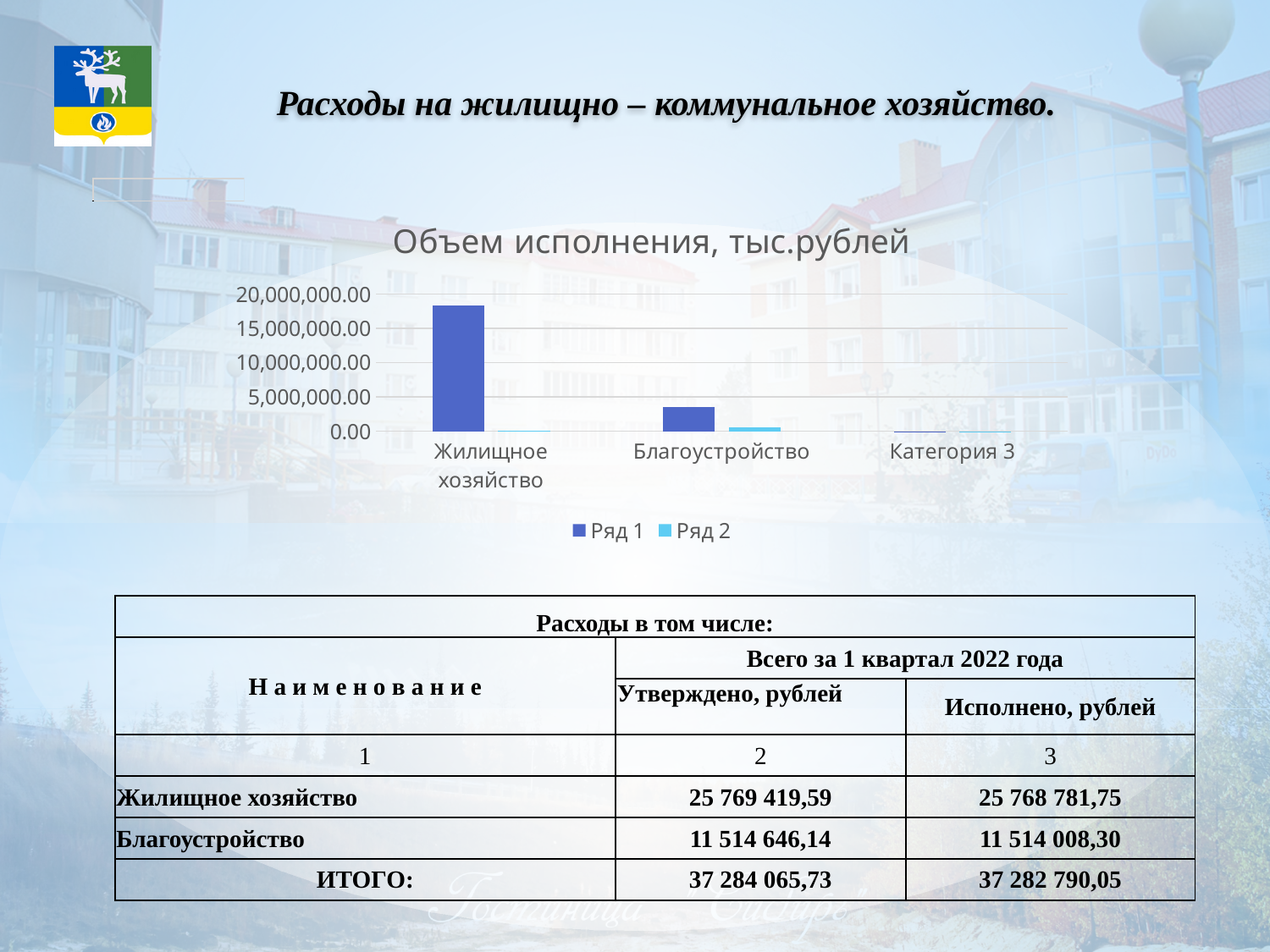
How many series does the chart legend list? 2 Is the Ряд 2 value for Благоустройство greater or less than 5,000,000.00? less Is the Ряд 1 value for Благоустройство greater or less than 5,000,000.00? less What is the title of the chart? Объем исполнения, тыс.рублей Is the Ряд 1 value for Жилищное хозяйство greater or less than 15,000,000.00? greater What are the names of the two series in the chart legend? Ряд 1 and Ряд 2 Which category has the lowest value for Ряд 1? Категория 3 Which category has the highest value for Ряд 1? Жилищное хозяйство Which is larger for Ряд 1: Жилищное хозяйство or Благоустройство? Жилищное хозяйство What kind of chart is shown on the slide? bar chart How many categories are shown on the x axis of the chart? 3 Do the Ряд 1 values rise or fall from left to right along the x axis? fall